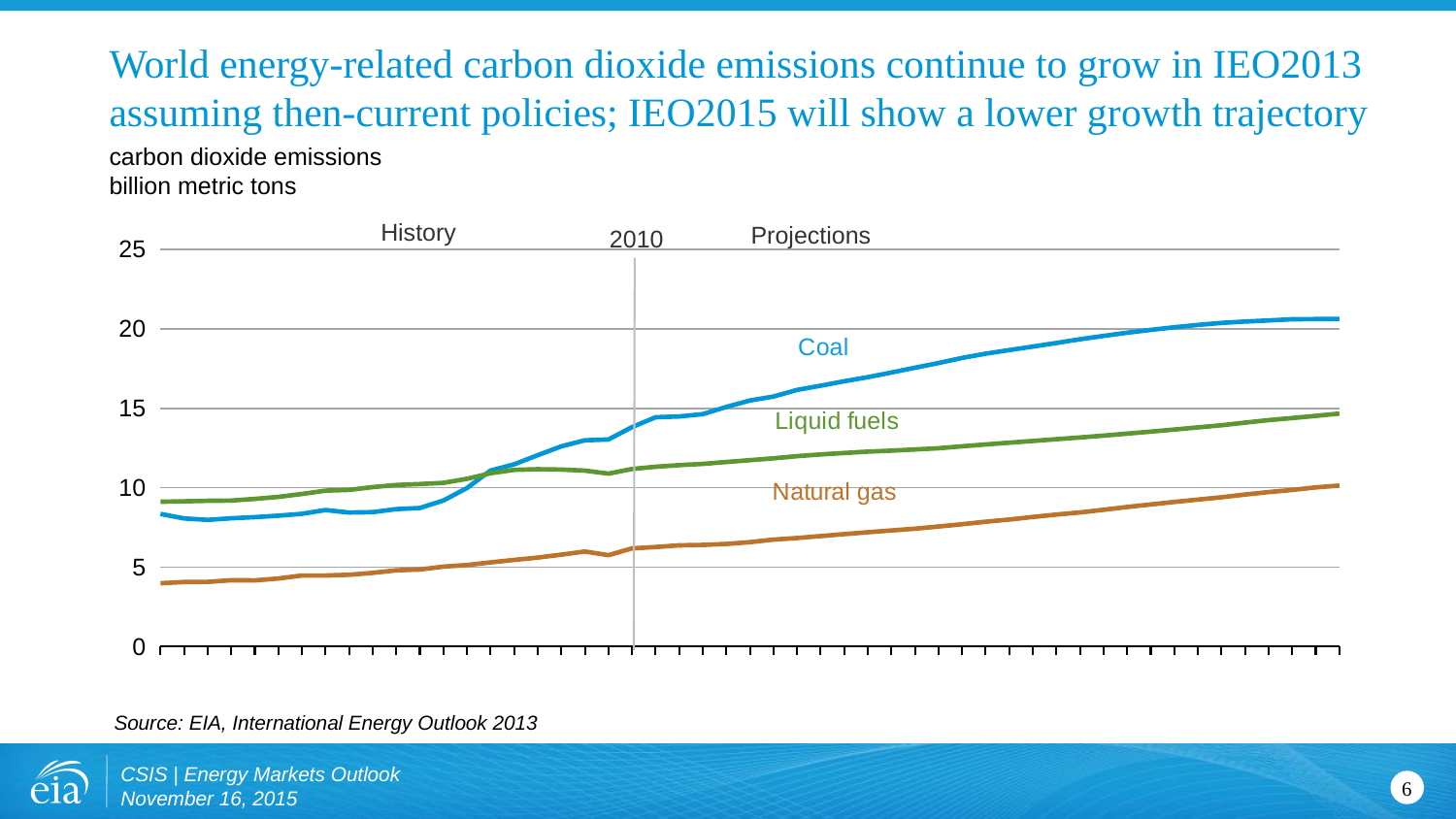
At the left end of the chart (start of the history period), which is larger: Coal or Liquid fuels? Liquid fuels In what unit are the carbon dioxide emissions measured on the chart? billion metric tons Is the value for Natural gas at the right end of the projection period greater or less than 15? less What kind of chart is shown on the slide? line chart Is the value for Coal at the 2010 line greater or less than 10? greater Is the value for Natural gas at the left end of the chart greater or less than 5? less Which series has the lowest value at the right end of the projection period? Natural gas How many series are plotted on the chart? 3 Which series has the highest value at the right end of the projection period? Coal At the right end of the chart, which is larger: Coal or Liquid fuels? Coal Do the Natural gas emissions rise or fall over the projection period? rise